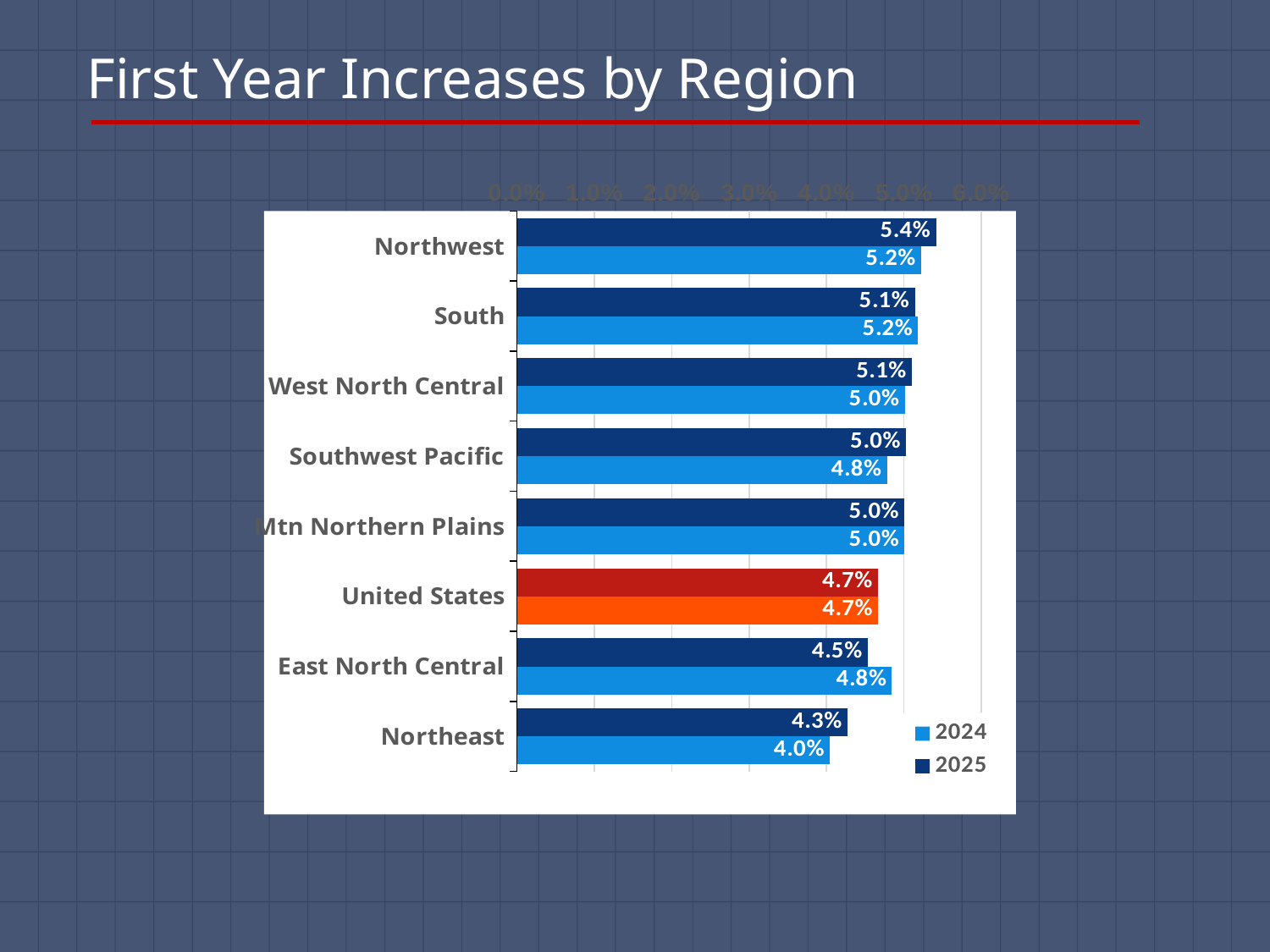
What is the 2024 value for East North Central? 4.8% What is the 2025 value for Northwest? 5.4% What kind of chart is shown on the slide? Bar chart Which region has the highest 2025 value? Northwest How many series does the legend list? 2 How many regions are shown on the chart? 8 Which is larger for East North Central, the 2024 value or the 2025 value? 2024 What is the 2025 value for the United States? 4.7% What is the difference between the 2025 and 2024 values for Northeast? 0.3 percentage points What is the 2024 value for Northeast? 4.0% Which region has the lowest 2024 value? Northeast What is the difference between the 2025 and 2024 values for Northwest? 0.2 percentage points